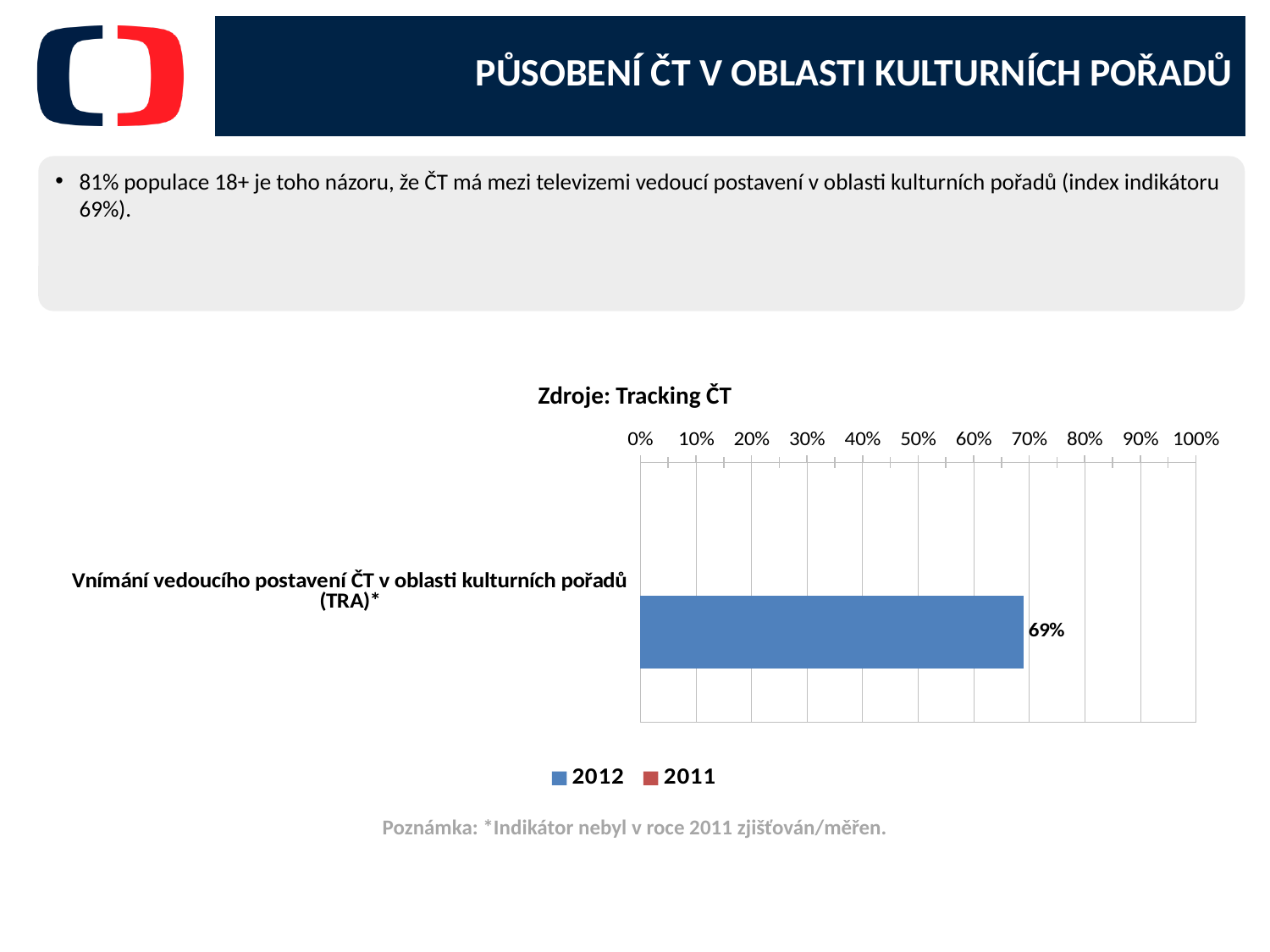
Which series has a bar plotted on the chart? 2012 How many categories are plotted on the chart? 1 What is the title of the chart? Zdroje: Tracking ČT What kind of chart is shown on the slide? bar chart Is the value for 2012 greater or less than 70%? less How many series does the legend list? 2 Is the value for 2012 greater or less than 60%? greater What is the highest value shown on the x axis? 100% What is the value for 2012 for 'Vnímání vedoucího postavení ČT v oblasti kulturních pořadů (TRA)*'? 69% Which series are listed in the chart legend? 2012 and 2011